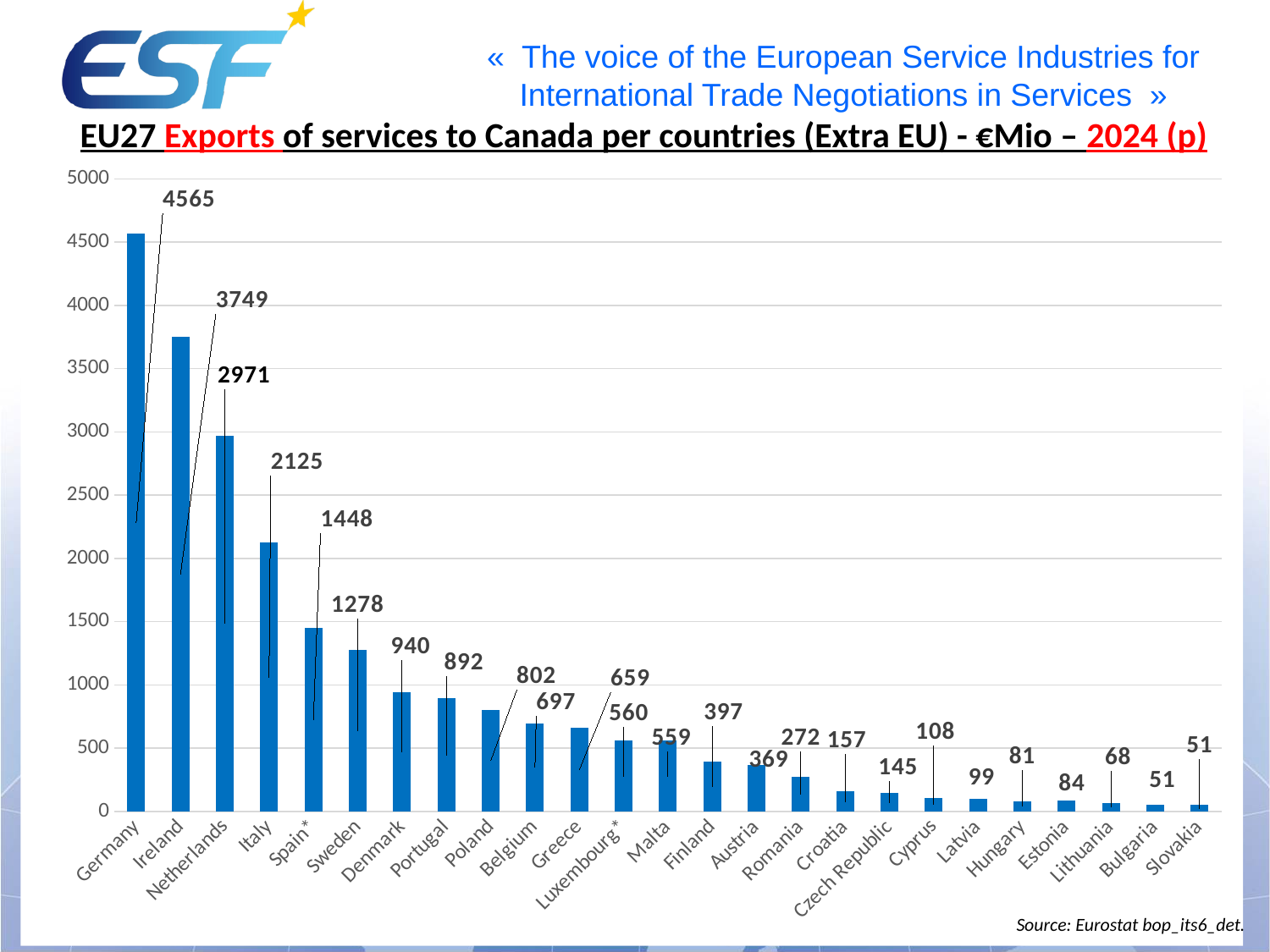
What is the value for Italy? 2125 What is the difference between the values for Germany and Ireland? 816 How many countries are shown on the chart? 25 What is the value for Finland? 397 What kind of chart is this? bar chart Which country has the highest value? Germany What is the value for Ireland? 3749 Do the values rise or fall from left to right along the x axis? fall What is the value for Sweden? 1278 Which has a larger value, Denmark or Portugal? Denmark Is the value for Netherlands greater or less than 2500? greater What is the value for Germany? 4565